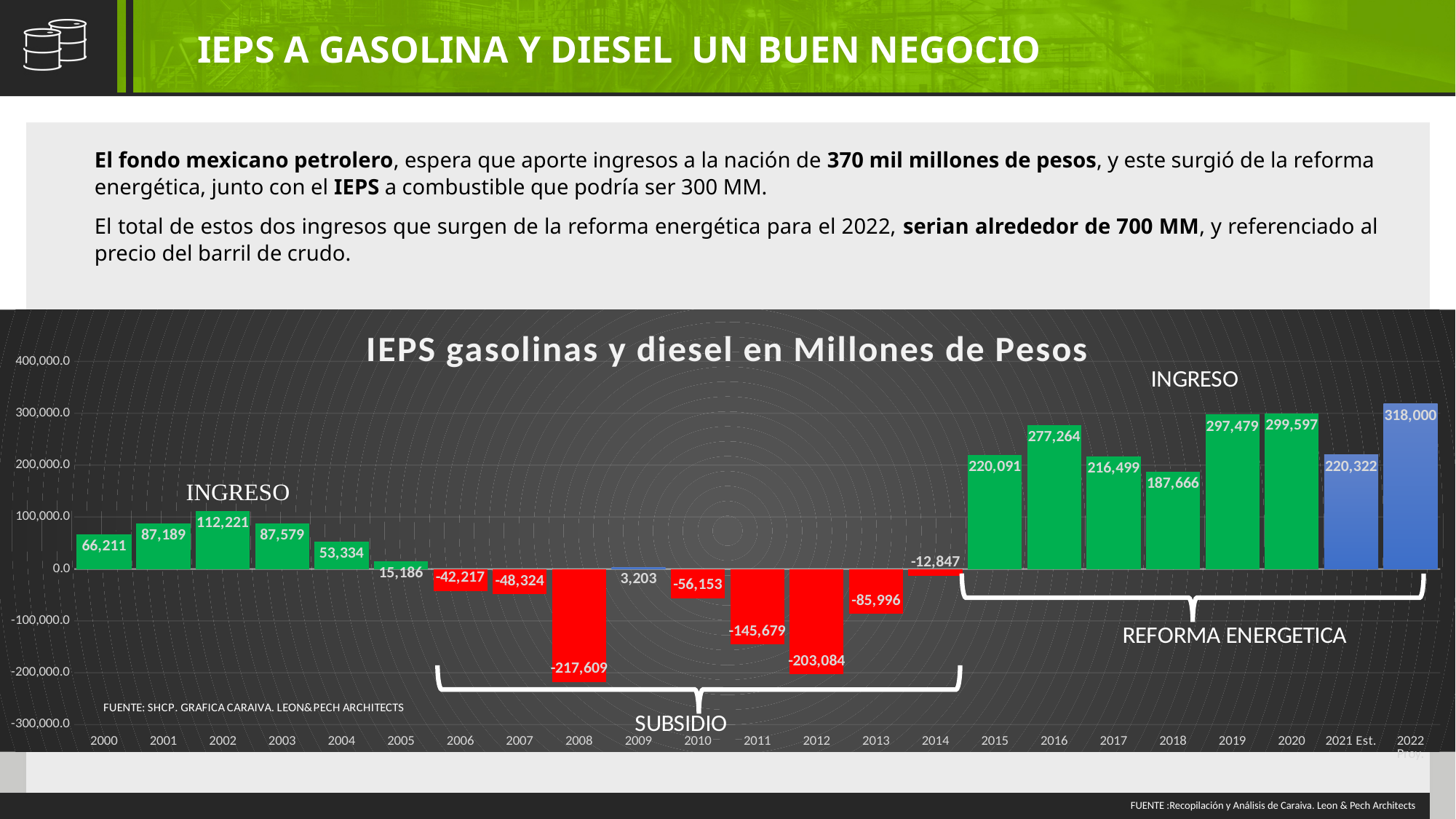
Is the value for 2019 greater or less than 200,000.0? greater What is the difference between the values for 2016 and 2015? 57,173 What is the difference between the values for 2020 and 2019? 2,118 What kind of chart is shown on the slide? bar chart What is the value for 2016 in the IEPS gasolinas y diesel chart? 277,264 What is the value shown for 2022 Proy. in the chart? 318,000 Which year has the lowest value in the IEPS gasolinas y diesel chart? 2008 Which year has the highest value in the IEPS gasolinas y diesel chart? 2022 Which year has the larger value, 2002 or 2003? 2002 What is the value for 2008 in the IEPS gasolinas y diesel chart? -217,609 What is the title of the chart on the slide? IEPS gasolinas y diesel en Millones de Pesos How many years are shown on the x axis of the chart? 23